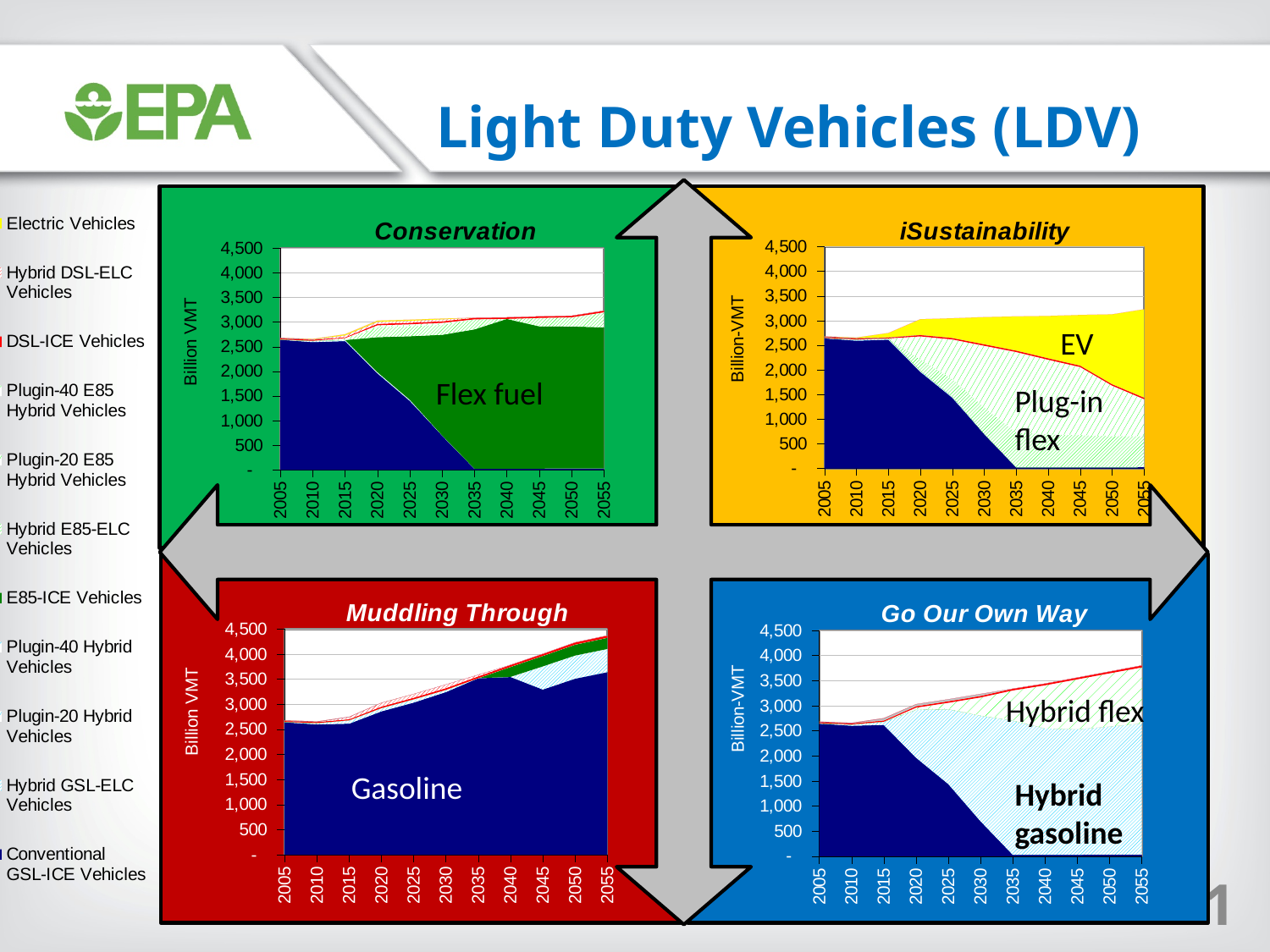
What is the y-axis label on the Conservation chart? Billion VMT In the Conservation chart, is the total value in 2005 greater or less than 2,500? greater What kind of chart is the Conservation chart? Area chart In the Muddling Through chart, is the total value in 2055 greater or less than 4,000? greater How many charts are shown on the slide? 4 Which chart has the larger total value in 2055, Muddling Through or Conservation? Muddling Through What is the title of the bottom-right chart? Go Our Own Way In the Conservation chart, does the dark blue (gasoline) area rise or fall from 2015 to 2035? fall In the iSustainability chart, is the total value in 2055 greater or less than 3,500? less In the Muddling Through chart, does the total value rise or fall from 2005 to 2055? rise How many year labels are on the x axis of the Muddling Through chart? 11